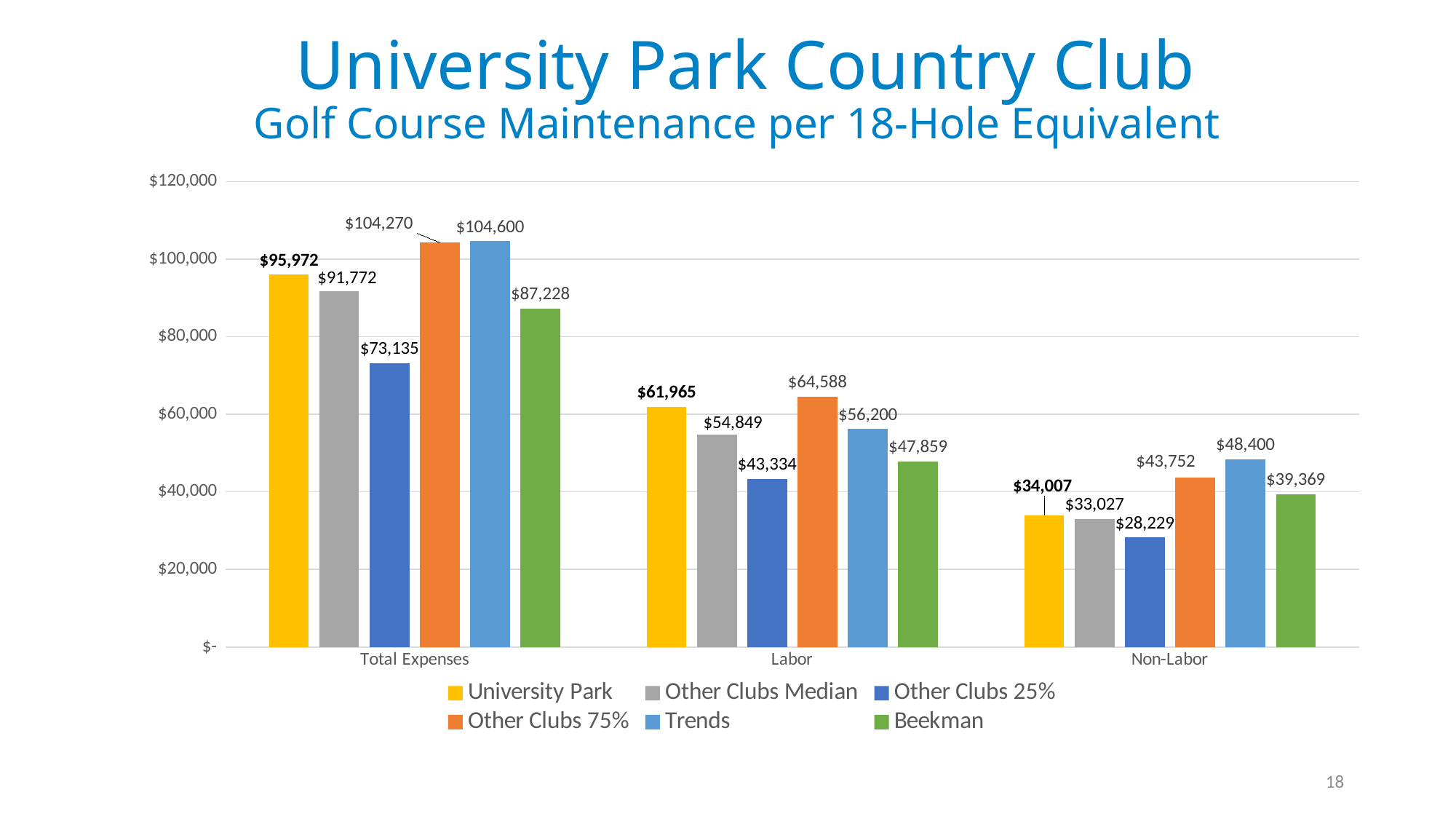
What is the Total Expenses value for University Park? $95,972 What is the Non-Labor value for Beekman? $39,369 Which series has the highest Labor value? Other Clubs 75% How many categories are shown on the x axis? 3 What is the difference between Trends and Beekman for Non-Labor? $9,031 What is the difference between University Park and Other Clubs Median for Total Expenses? $4,200 Is the Total Expenses value for Beekman greater or less than $80,000? greater How many series does the legend list? 6 For Labor, which is larger: University Park or Trends? University Park What is the Labor value for Other Clubs 25%? $43,334 What kind of chart is shown on the slide? Bar chart Which series has the lowest Non-Labor value? Other Clubs 25%